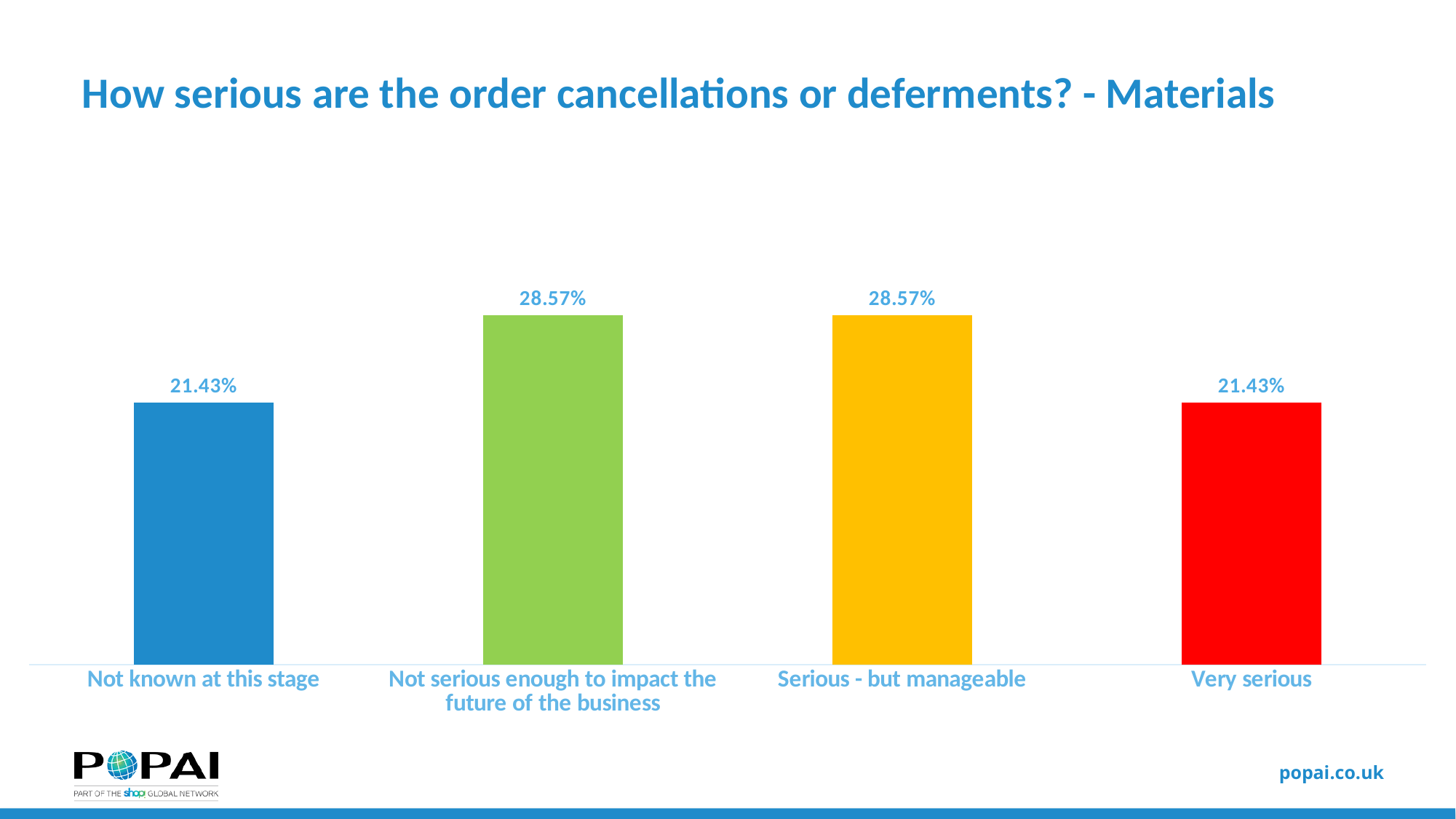
What is the value for 'Serious - but manageable'? 28.57% What is the total of the values for 'Not known at this stage' and 'Very serious'? 42.86% What is the value for 'Very serious'? 21.43% Which is larger, the value for 'Very serious' or the value for 'Serious - but manageable'? Serious - but manageable What is the value for 'Not serious enough to impact the future of the business'? 28.57% What is the difference between the values for 'Serious - but manageable' and 'Very serious'? 7.14% What colour is the bar for 'Very serious'? Red How many categories are shown in the chart? 4 Which is larger, the value for 'Not serious enough to impact the future of the business' or the value for 'Not known at this stage'? Not serious enough to impact the future of the business What is the value for 'Not known at this stage'? 21.43% What is the title of the slide? How serious are the order cancellations or deferments? - Materials What kind of chart is shown on the slide? Bar chart